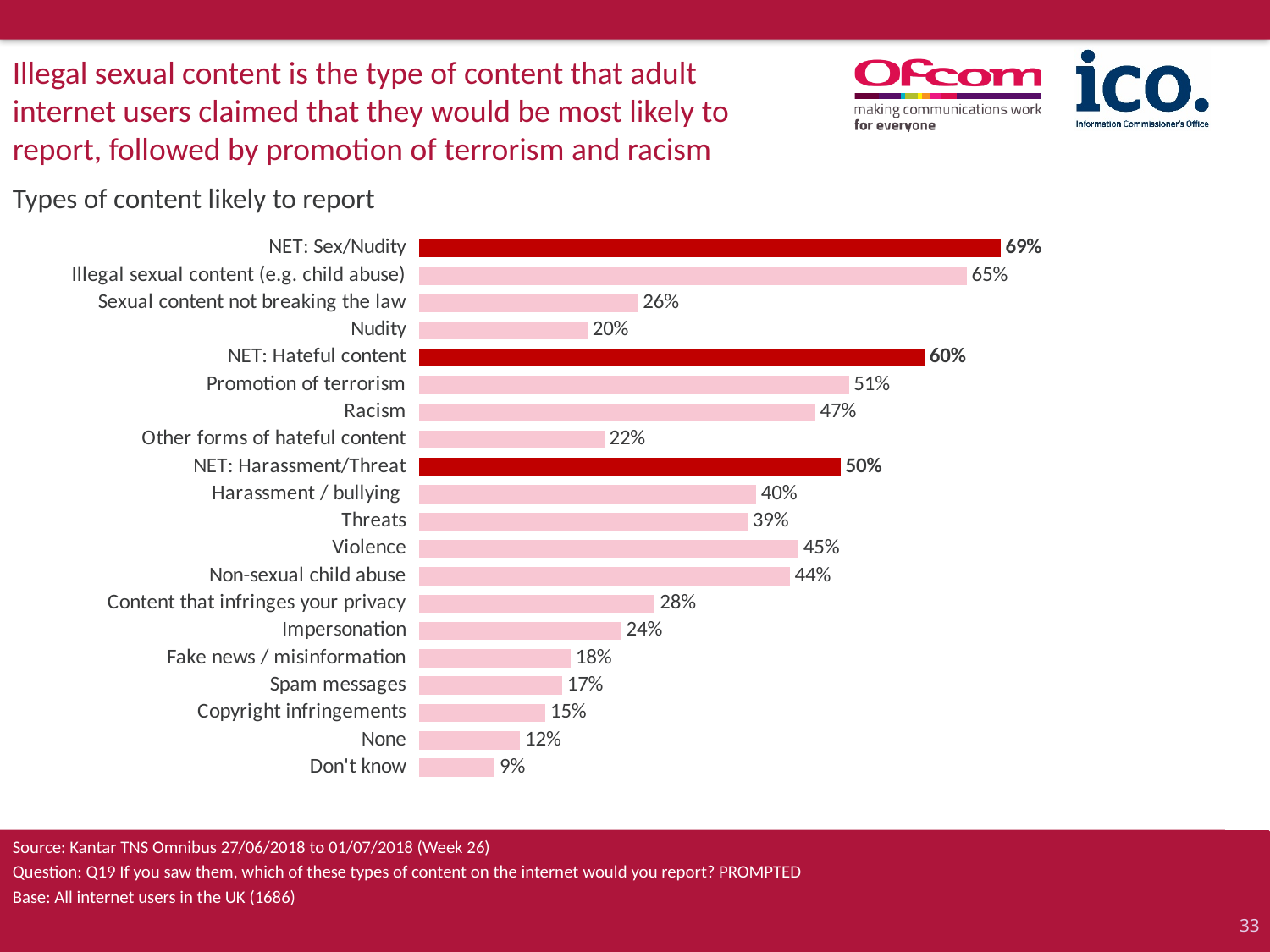
What kind of chart is shown on the slide? Bar chart Which is larger, the value for Violence or the value for Harassment / bullying? Violence What is the difference between the values for NET: Sex/Nudity and NET: Hateful content? 9% What is the difference between the values for Racism and Nudity? 27% What is the value for Spam messages? 17% What is the title of the chart? Types of content likely to report Which category has the highest value? NET: Sex/Nudity What is the value for Illegal sexual content (e.g. child abuse)? 65% What is the value for NET: Harassment/Threat? 50% How many categories are shown in the chart? 20 Which category has the lowest value? Don't know What is the value for Promotion of terrorism? 51%